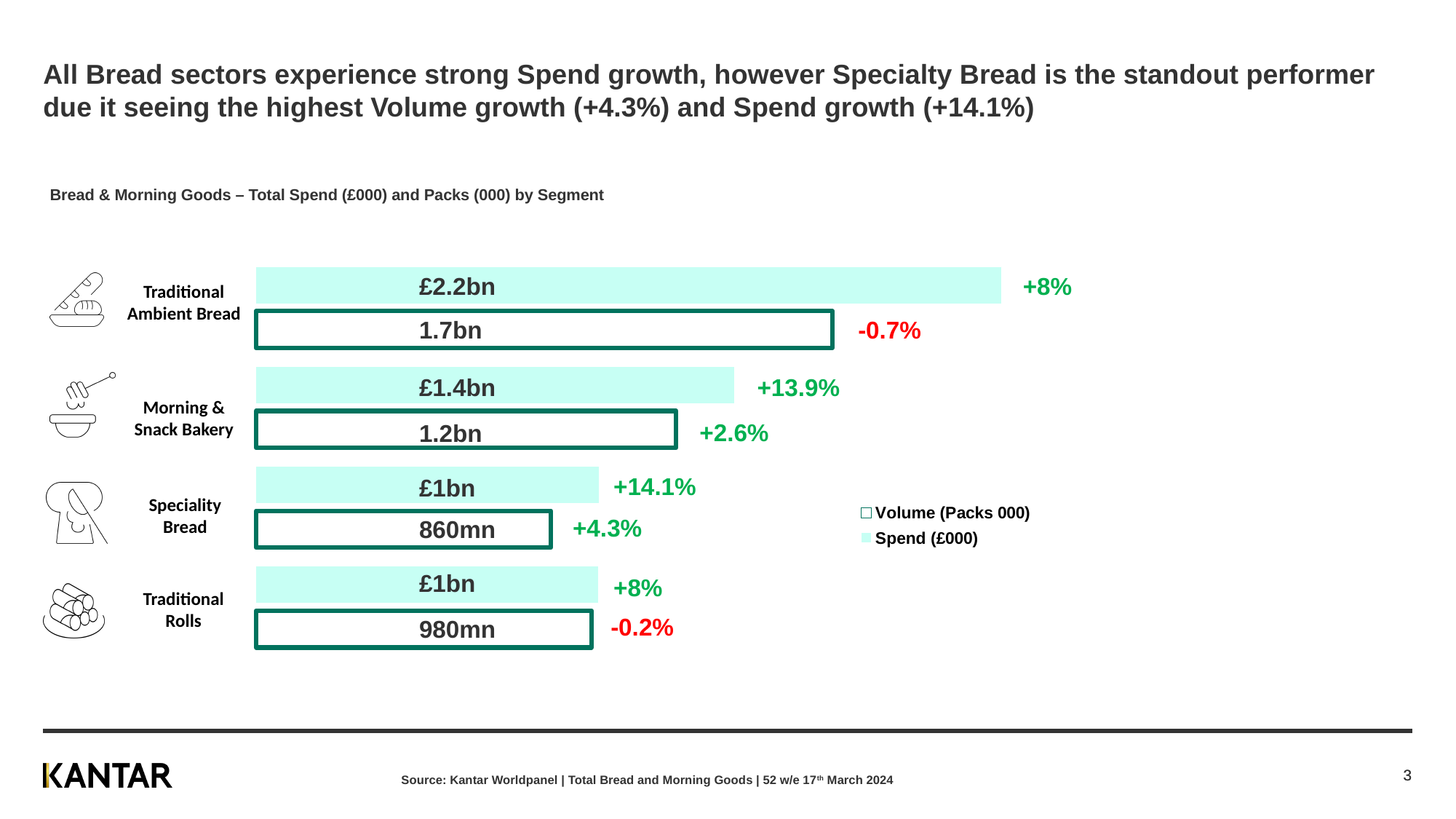
What is the Spend (£000) value shown for Traditional Ambient Bread? £2.2bn Which segment has the highest Spend (£000)? Traditional Ambient Bread How many segments are shown in the chart? 4 What is the Spend (£000) value shown for Morning & Snack Bakery? £1.4bn What kind of chart is shown on the slide? Bar chart What percentage change is shown next to the Spend bar for Speciality Bread? +14.1% What is the Volume (Packs 000) value shown for Speciality Bread? 860mn What percentage change is shown next to the Volume bar for Traditional Ambient Bread? -0.7% Which segment has the lowest Volume (Packs 000)? Speciality Bread How many series does the legend list? 2 What is the Volume (Packs 000) value shown for Traditional Rolls? 980mn Which is larger, the Volume for Traditional Rolls or the Volume for Speciality Bread? Traditional Rolls